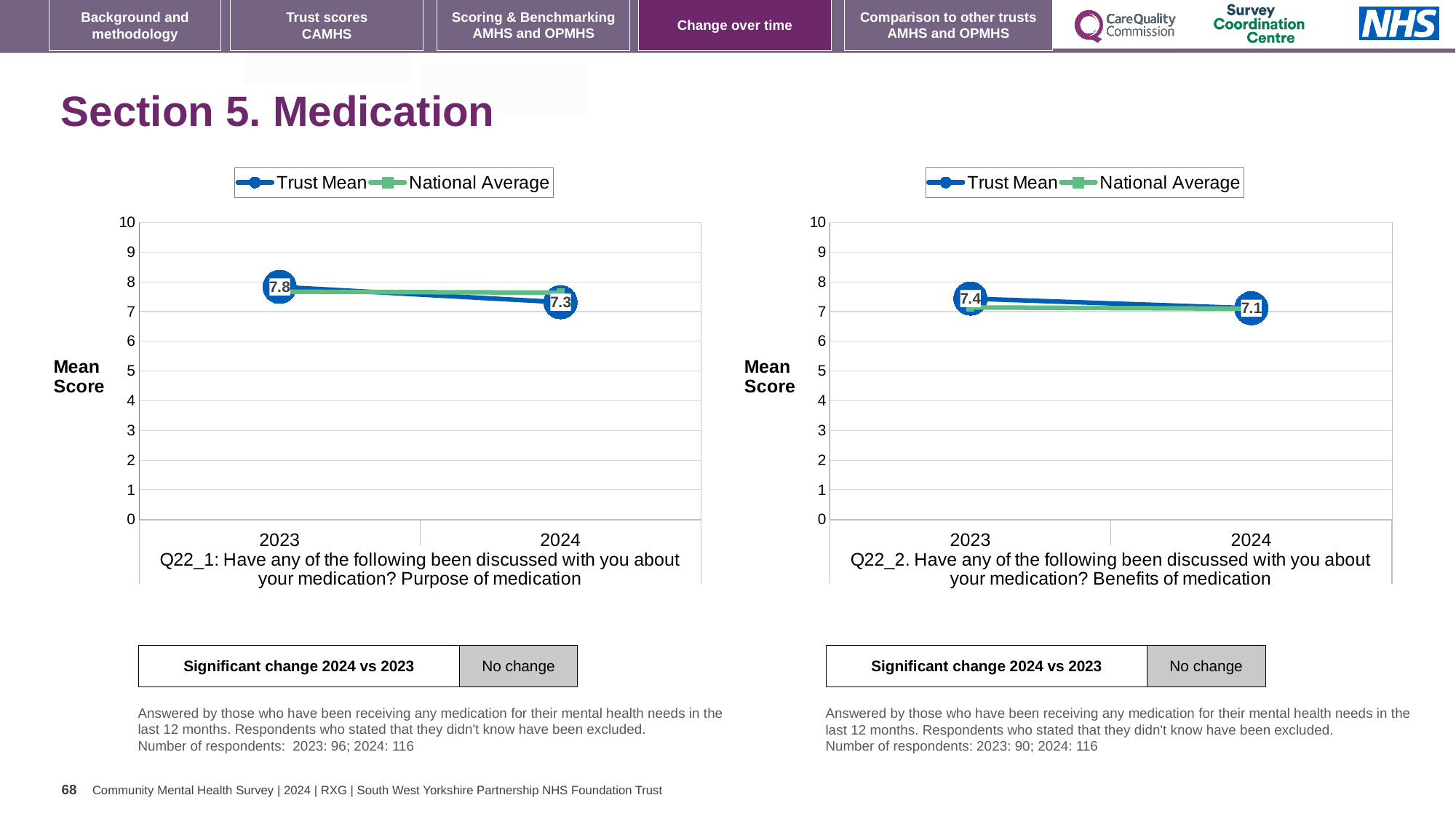
How many years are plotted on the x axis of the Q22_1 Purpose of medication chart? 2 In the Q22_2 Benefits of medication chart, what is the Trust Mean for 2023? 7.4 In the Q22_2 Benefits of medication chart, which year has the higher Trust Mean, 2023 or 2024? 2023 In the Q22_1 Purpose of medication chart, what is the Trust Mean for 2024? 7.3 In the Q22_1 Purpose of medication chart, is the National Average for 2024 greater or less than 5? greater In the Q22_1 Purpose of medication chart, what is the Trust Mean for 2023? 7.8 In the Q22_1 Purpose of medication chart, does the Trust Mean rise or fall from 2023 to 2024? fall In the Q22_2 Benefits of medication chart, what is the difference between the Trust Mean in 2023 and 2024? 0.3 In the Q22_2 Benefits of medication chart, what is the Trust Mean for 2024? 7.1 In the Q22_1 Purpose of medication chart, by how much did the Trust Mean change from 2023 to 2024? 0.5 How many series does the legend list in the Q22_2 Benefits of medication chart? 2 What kind of chart is used for Q22_1 Purpose of medication? line chart